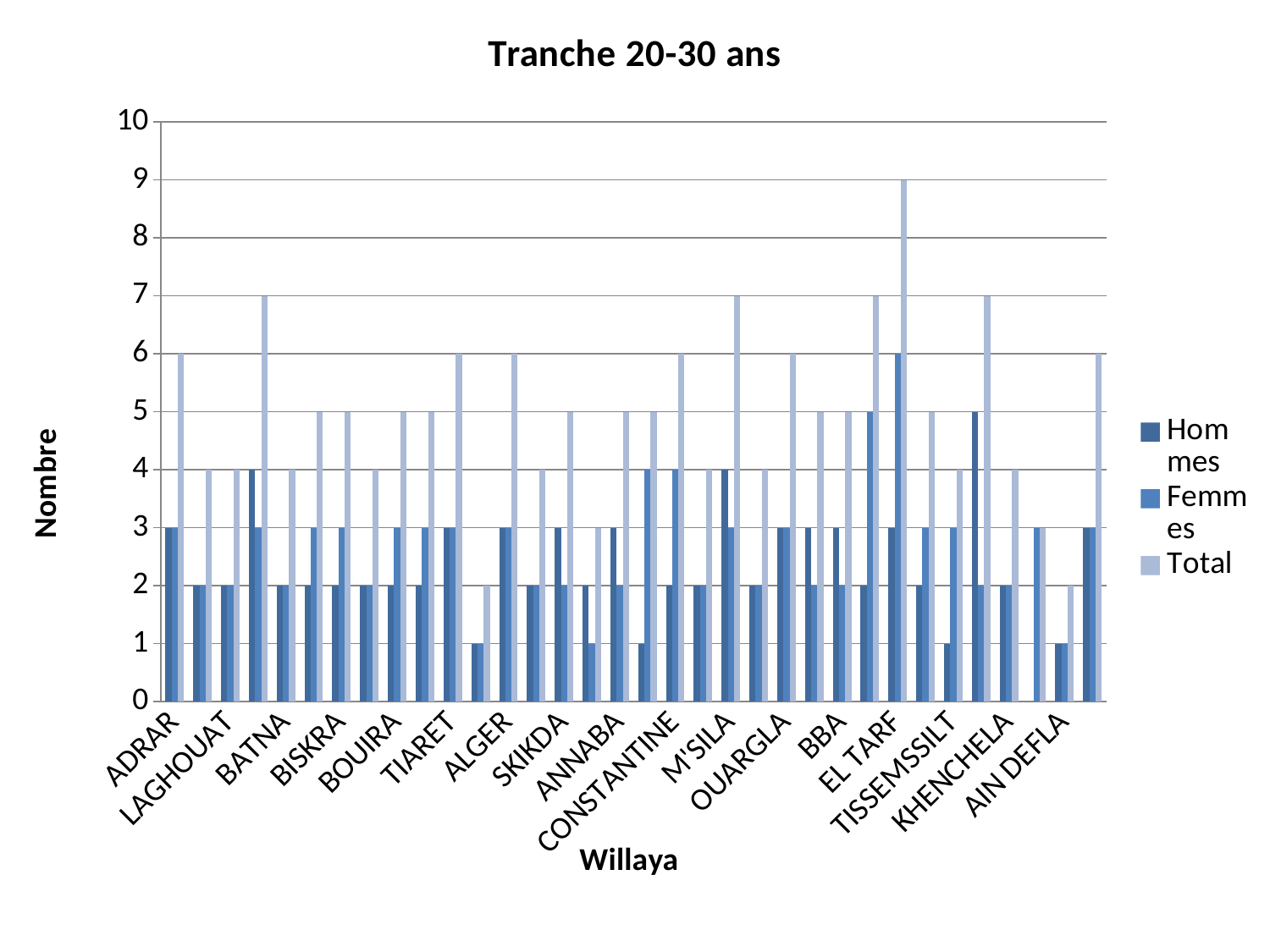
For EL TARF, which is larger, Hommes or Femmes? Femmes What is the Hommes value for ADRAR? 3 Which willaya has the highest Total value? EL TARF What is the title of the chart? Tranche 20-30 ans What is the Femmes value for EL TARF? 6 What is the Total value for ADRAR? 6 What is the difference between the Total value for EL TARF and the Total value for ADRAR? 3 Is the Total value for EL TARF greater or less than 8? greater What is the label of the vertical axis? Nombre How many series does the legend list? 3 What is the Total value for EL TARF? 9 What type of chart is shown on the slide? bar chart